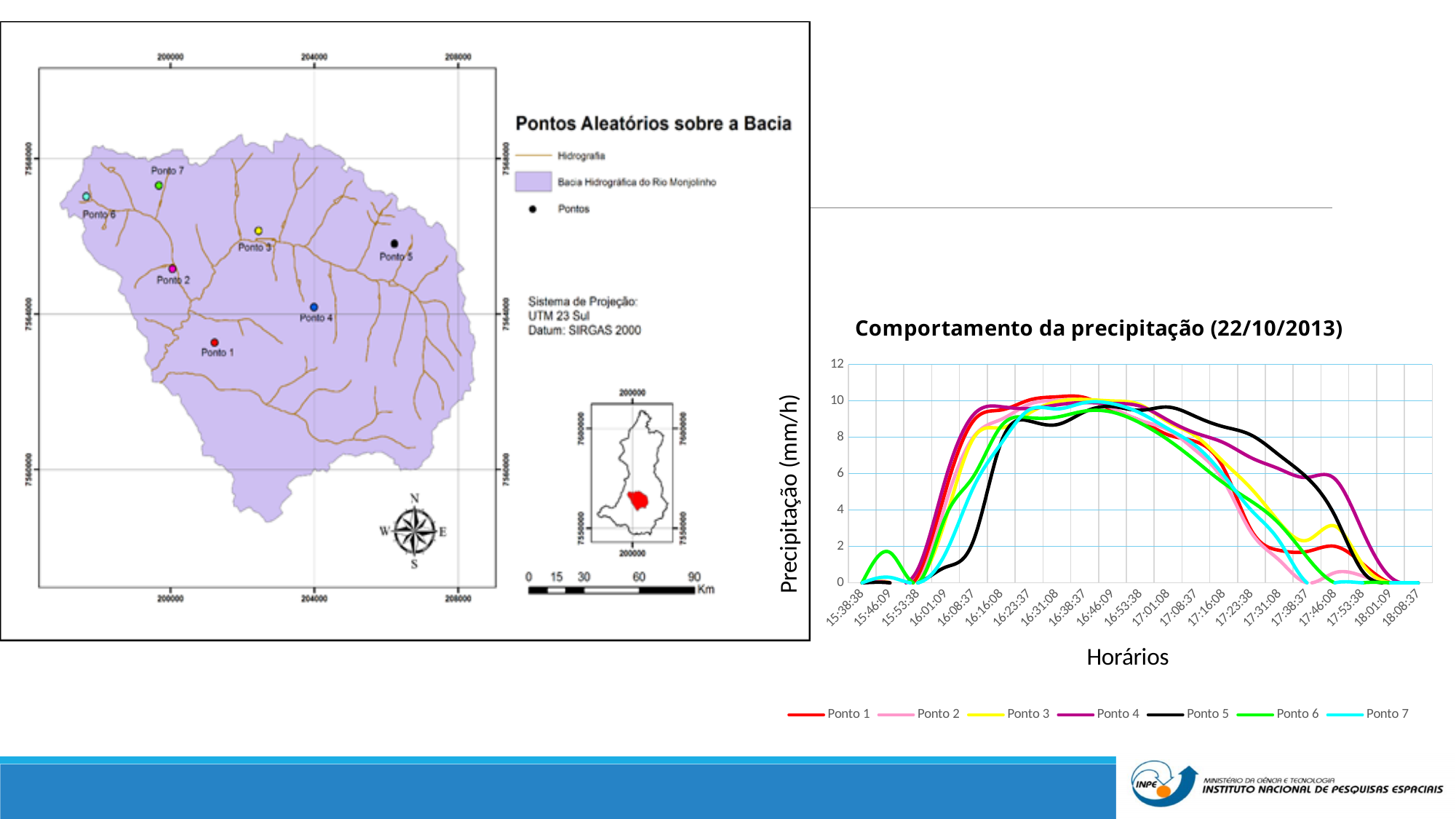
In the precipitation chart, is the value for Ponto 7 at 17:38:37 greater or less than 2? less In the precipitation chart, at 17:38:37, which is larger: Ponto 5 or Ponto 1? Ponto 5 In the precipitation chart, is the value for Ponto 5 at 17:01:08 greater or less than 8? greater In the precipitation chart, is the value for Ponto 4 at 17:46:08 greater or less than 4? greater What is the label of the vertical axis of the precipitation chart? Precipitação (mm/h) In the precipitation chart, do the values for Ponto 1 rise or fall between 15:53:38 and 16:31:08? rise How many series does the legend of the precipitation chart list? 7 What kind of chart is 'Comportamento da precipitação (22/10/2013)'? line chart In the precipitation chart, which series has the highest value at 17:46:08? Ponto 4 What is the title of the chart on the right side of the slide? Comportamento da precipitação (22/10/2013) How many time labels are shown along the x axis of the precipitation chart? 21